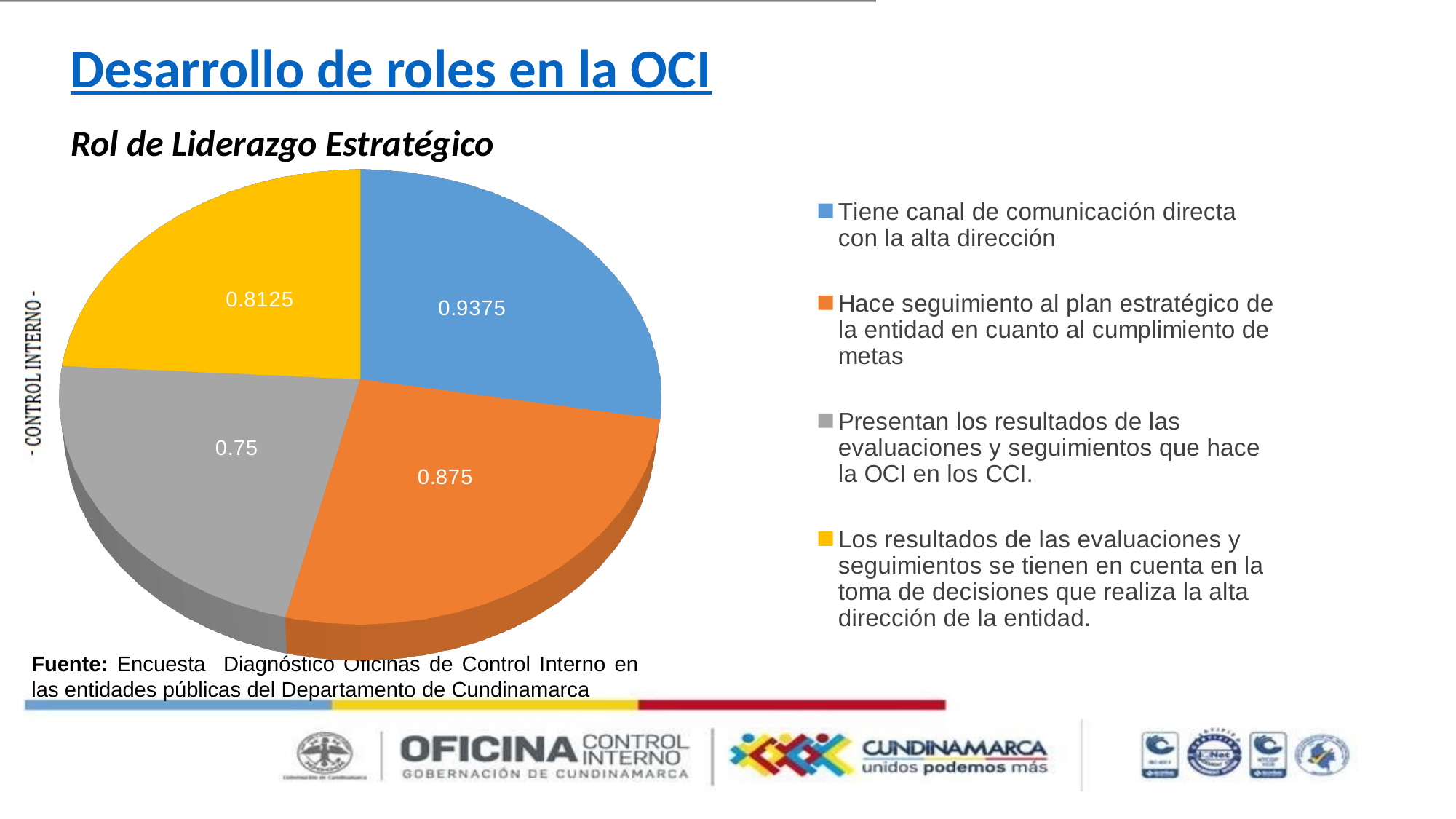
What is the difference between the value for "Tiene canal de comunicación directa con la alta dirección" and the value for "Presentan los resultados de las evaluaciones y seguimientos que hace la OCI en los CCI."? 0.1875 What type of chart is shown on the slide? Pie chart What is the value for "Hace seguimiento al plan estratégico de la entidad en cuanto al cumplimiento de metas"? 0.875 Which category has the highest value in the pie chart? Tiene canal de comunicación directa con la alta dirección What is the value for "Presentan los resultados de las evaluaciones y seguimientos que hace la OCI en los CCI."? 0.75 How many slices does the pie chart have? 4 Which is larger: the value for "Hace seguimiento al plan estratégico de la entidad en cuanto al cumplimiento de metas" or the value for "Los resultados de las evaluaciones y seguimientos se tienen en cuenta en la toma de decisiones que realiza la alta dirección de la entidad."? Hace seguimiento al plan estratégico de la entidad en cuanto al cumplimiento de metas What is the value for "Tiene canal de comunicación directa con la alta dirección"? 0.9375 What is the subtitle shown above the pie chart? Rol de Liderazgo Estratégico Which category has the lowest value in the pie chart? Presentan los resultados de las evaluaciones y seguimientos que hace la OCI en los CCI. What is the value for "Los resultados de las evaluaciones y seguimientos se tienen en cuenta en la toma de decisiones que realiza la alta dirección de la entidad."? 0.8125 What colour is the slice for "Presentan los resultados de las evaluaciones y seguimientos que hace la OCI en los CCI."? Gray